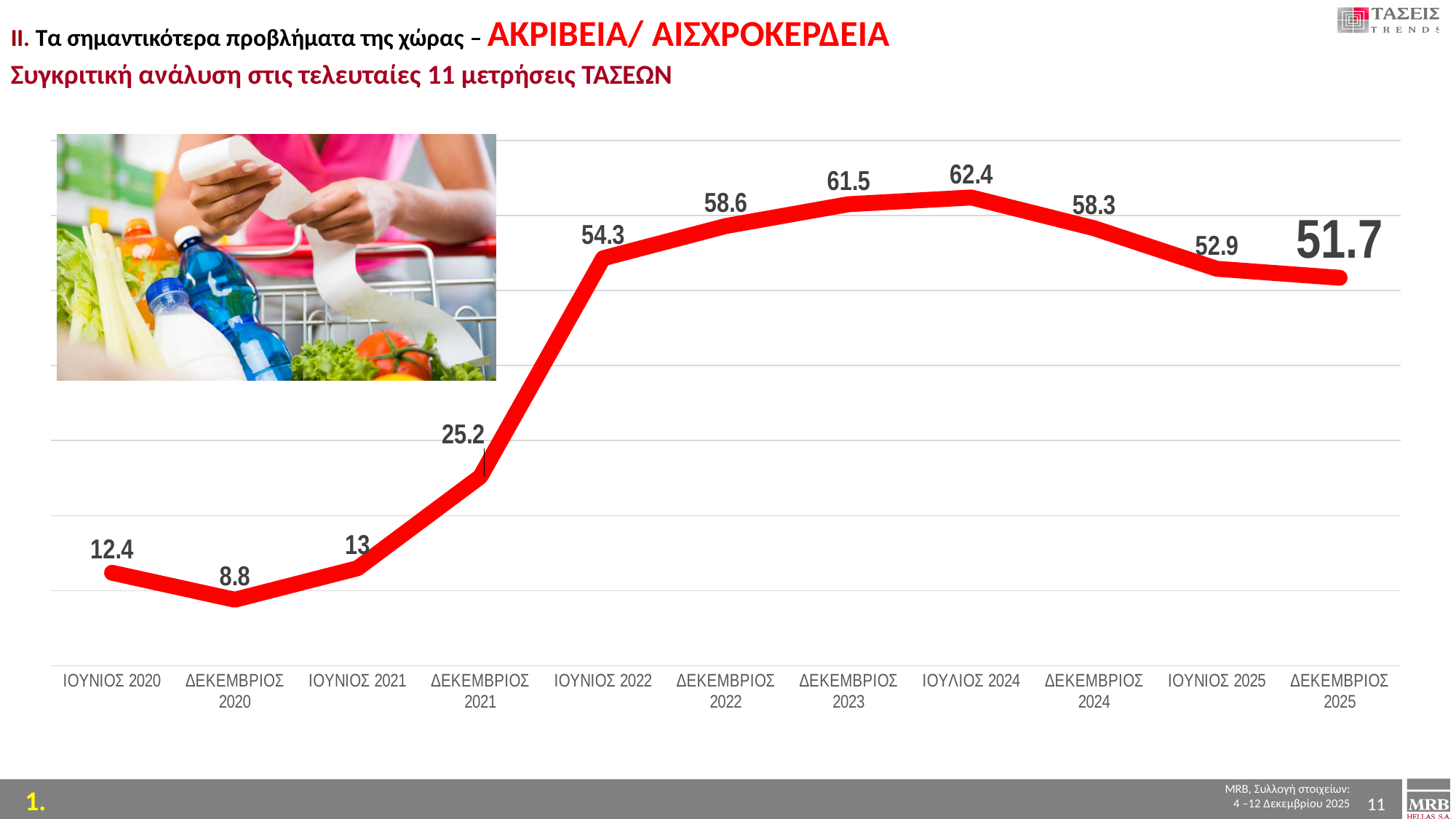
What is the difference between the values for ΙΟΥΝΙΟΣ 2022 and ΔΕΚΕΜΒΡΙΟΣ 2021? 29.1 How many measurement points are plotted on the chart? 11 What value is shown for ΔΕΚΕΜΒΡΙΟΣ 2025? 51.7 Does the value rise or fall from ΙΟΥΛΙΟΣ 2024 to ΔΕΚΕΜΒΡΙΟΣ 2025? Fall Which measurement has the lowest value? ΔΕΚΕΜΒΡΙΟΣ 2020 What colour is the line in the chart? Red What kind of chart is shown on the slide? Line chart Which measurement has the highest value? ΙΟΥΛΙΟΣ 2024 What value is shown for ΙΟΥΝΙΟΣ 2022? 54.3 What value is shown for ΔΕΚΕΜΒΡΙΟΣ 2021? 25.2 What is the difference between the values for ΙΟΥΛΙΟΣ 2024 and ΔΕΚΕΜΒΡΙΟΣ 2025? 10.7 Which is larger, the value for ΔΕΚΕΜΒΡΙΟΣ 2022 or the value for ΔΕΚΕΜΒΡΙΟΣ 2024? ΔΕΚΕΜΒΡΙΟΣ 2022